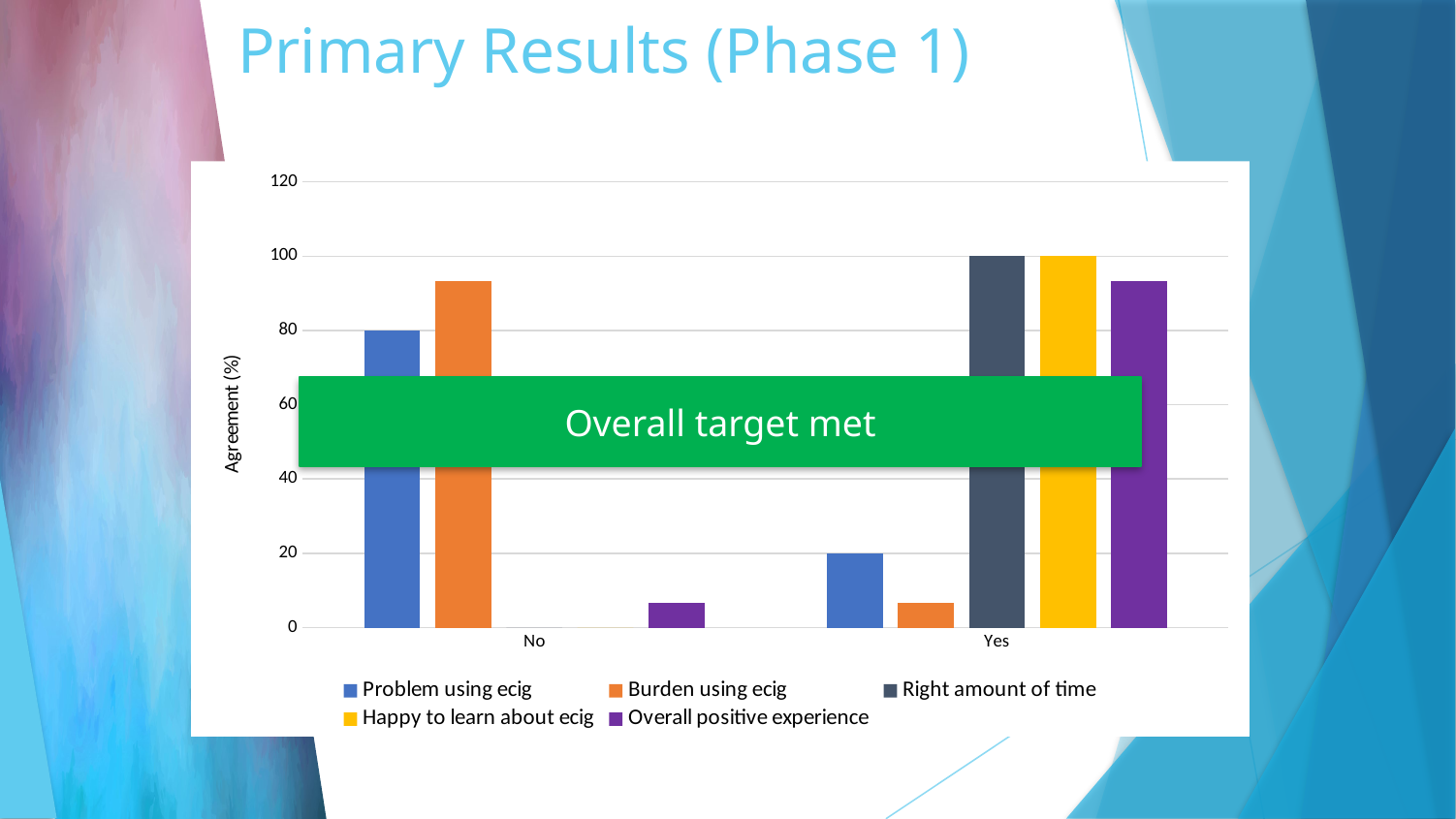
Which is larger for Problem using ecig: the No value or the Yes value? No What is the value for Problem using ecig in the Yes category? 20 What is the difference between the Problem using ecig values for No and Yes? 60 What is the value for Problem using ecig in the No category? 80 Is the value for Burden using ecig in the No category greater or less than 80? greater What is the label on the y axis? Agreement (%) How many categories are shown on the x axis? 2 Is the value for Overall positive experience in the No category greater or less than 20? less What is the value for Happy to learn about ecig in the Yes category? 100 What kind of chart is shown on the slide? Bar chart How many series does the legend list? 5 What is the value for Right amount of time in the Yes category? 100